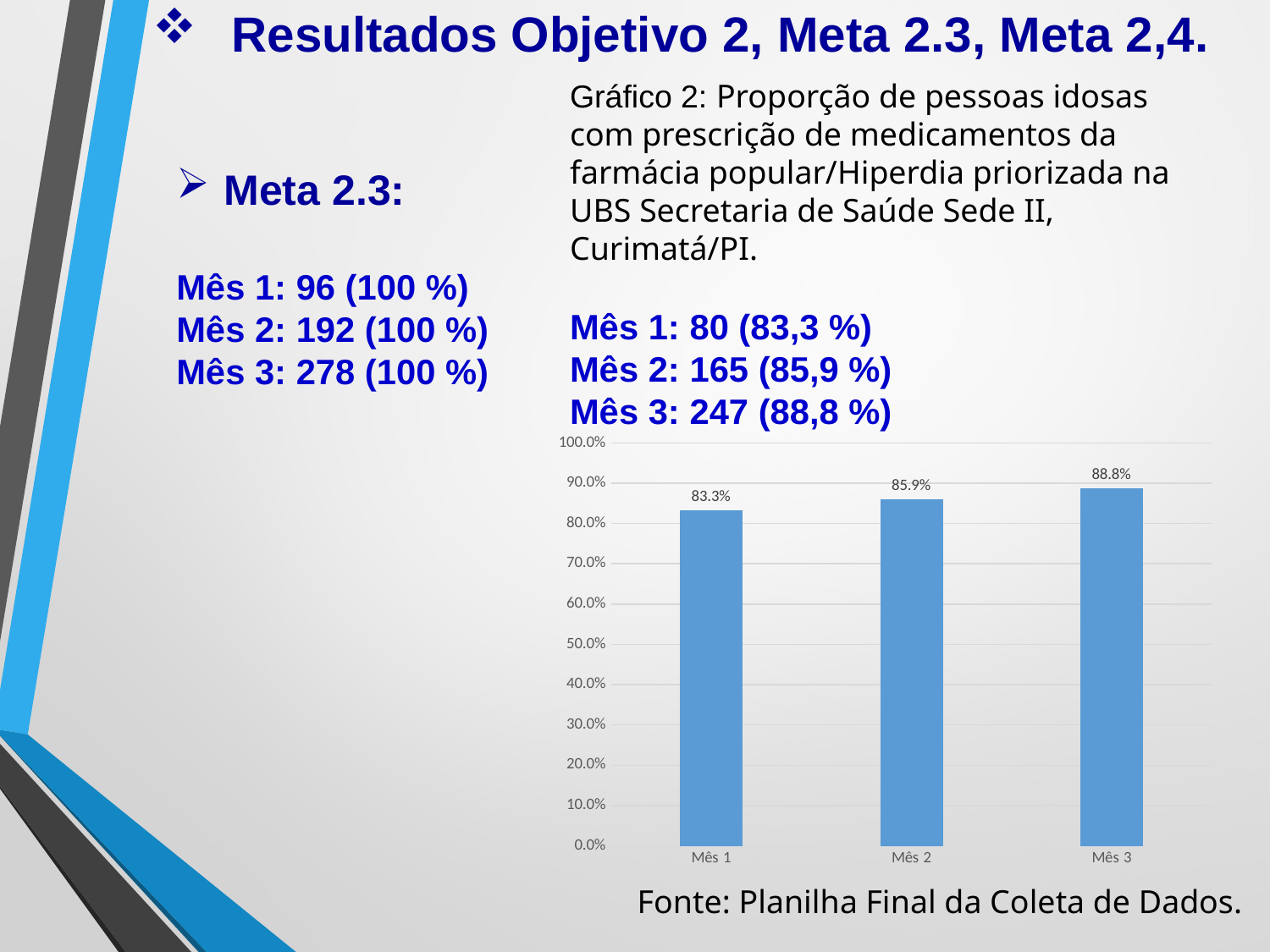
Which month has the highest value in the chart? Mês 3 What is the difference between the values for Mês 2 and Mês 1? 2.6% What is the difference between the values for Mês 3 and Mês 1? 5.5% What is the value for Mês 1 in the chart? 83.3% What is the value for Mês 3 in the chart? 88.8% Do the values rise or fall from Mês 1 to Mês 3? rise How many months are plotted in the chart? 3 Which month has the lowest value in the chart? Mês 1 What kind of chart is shown on the slide? bar chart What is the value for Mês 2 in the chart? 85.9% Is the value for Mês 1 greater or less than 90.0%? less Which is larger, the value for Mês 2 or the value for Mês 3? Mês 3